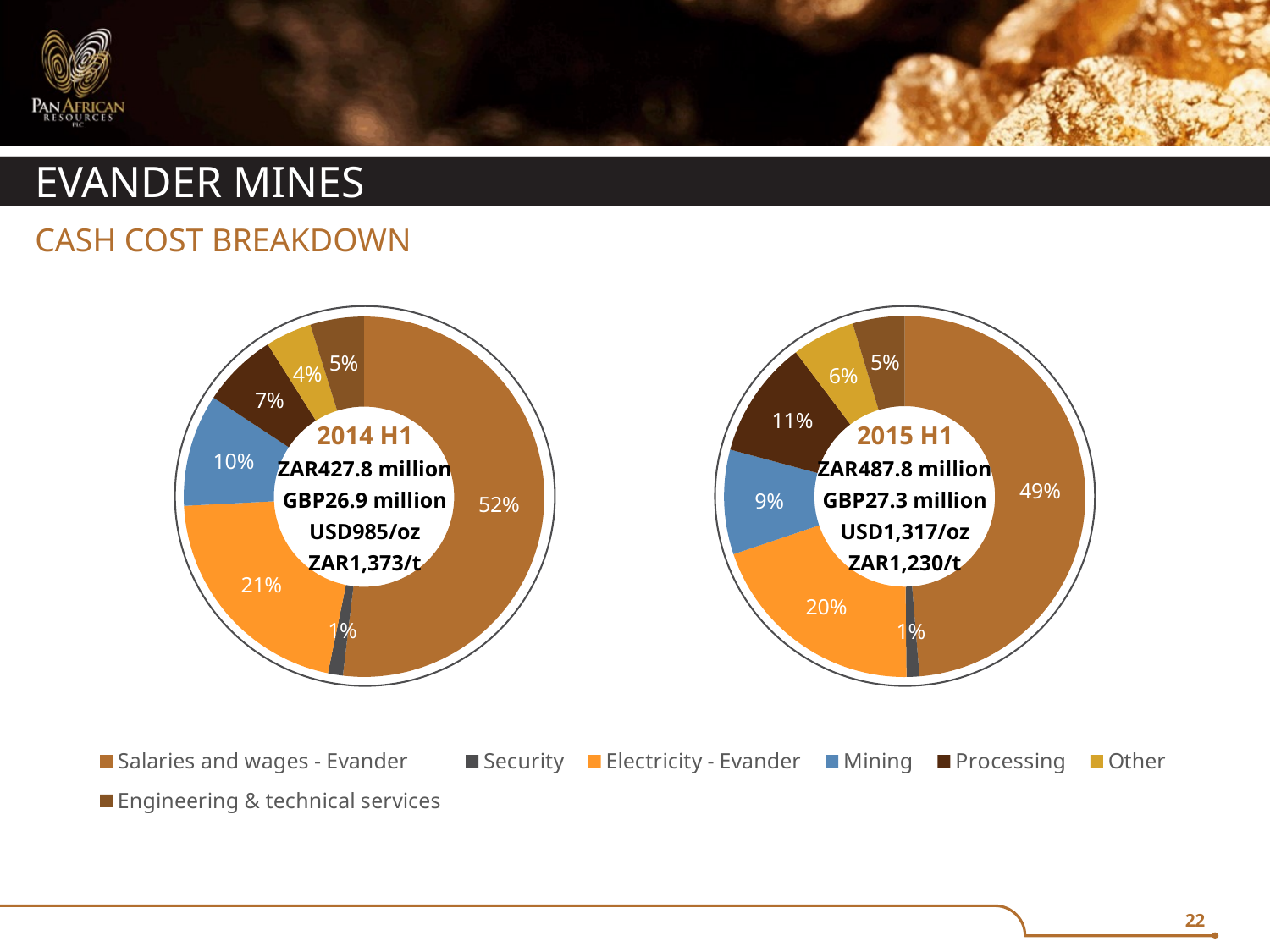
In the 2015 H1 chart, what percentage is shown for Mining? 9% In the 2014 H1 chart, which category has the largest share? Salaries and wages - Evander What is the difference between the Processing share in 2015 H1 and in 2014 H1? 4% In the 2015 H1 chart, which category has the smallest share? Security What total cash cost in ZAR is shown in the centre of the 2015 H1 chart? ZAR487.8 million How many categories does the legend list? 7 Is the Mining share larger in the 2014 H1 chart or the 2015 H1 chart? 2014 H1 In the 2014 H1 chart, what share of cash cost is Salaries and wages - Evander? 52% In the 2014 H1 chart, what percentage is shown for Electricity - Evander? 21% What kind of chart is used on this slide? Pie (doughnut) chart In the 2015 H1 chart, what percentage is shown for Processing? 11% In the 2015 H1 chart, what share of cash cost is Salaries and wages - Evander? 49%